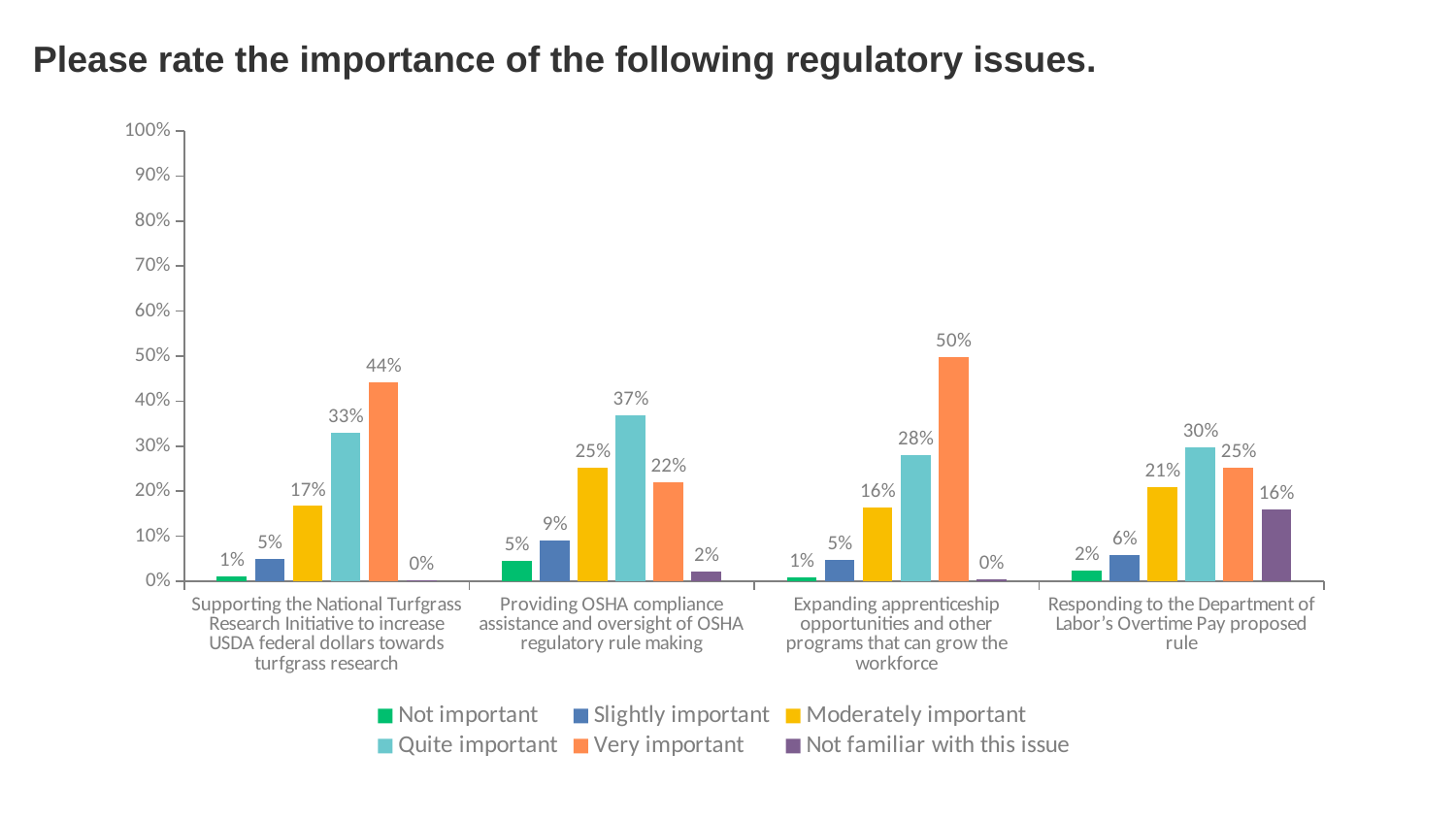
How many regulatory issues are shown on the x axis? 4 What is the difference between the Very important and Quite important percentages for 'Expanding apprenticeship opportunities and other programs that can grow the workforce'? 22% What kind of chart is shown on the slide? Bar chart Which regulatory issue has the lowest Very important percentage? Providing OSHA compliance assistance and oversight of OSHA regulatory rule making What percentage rated 'Supporting the National Turfgrass Research Initiative to increase USDA federal dollars towards turfgrass research' as Very important? 44% What percentage rated 'Providing OSHA compliance assistance and oversight of OSHA regulatory rule making' as Quite important? 37% Which regulatory issue has the highest Very important percentage? Expanding apprenticeship opportunities and other programs that can grow the workforce How many series does the legend list? 6 What colour represents the 'Very important' series in the legend? Orange Which is larger for 'Responding to the Department of Labor's Overtime Pay proposed rule': the Quite important percentage or the Very important percentage? Quite important What percentage were Not familiar with the issue 'Responding to the Department of Labor's Overtime Pay proposed rule'? 16% What is the Moderately important percentage for 'Expanding apprenticeship opportunities and other programs that can grow the workforce'? 16%